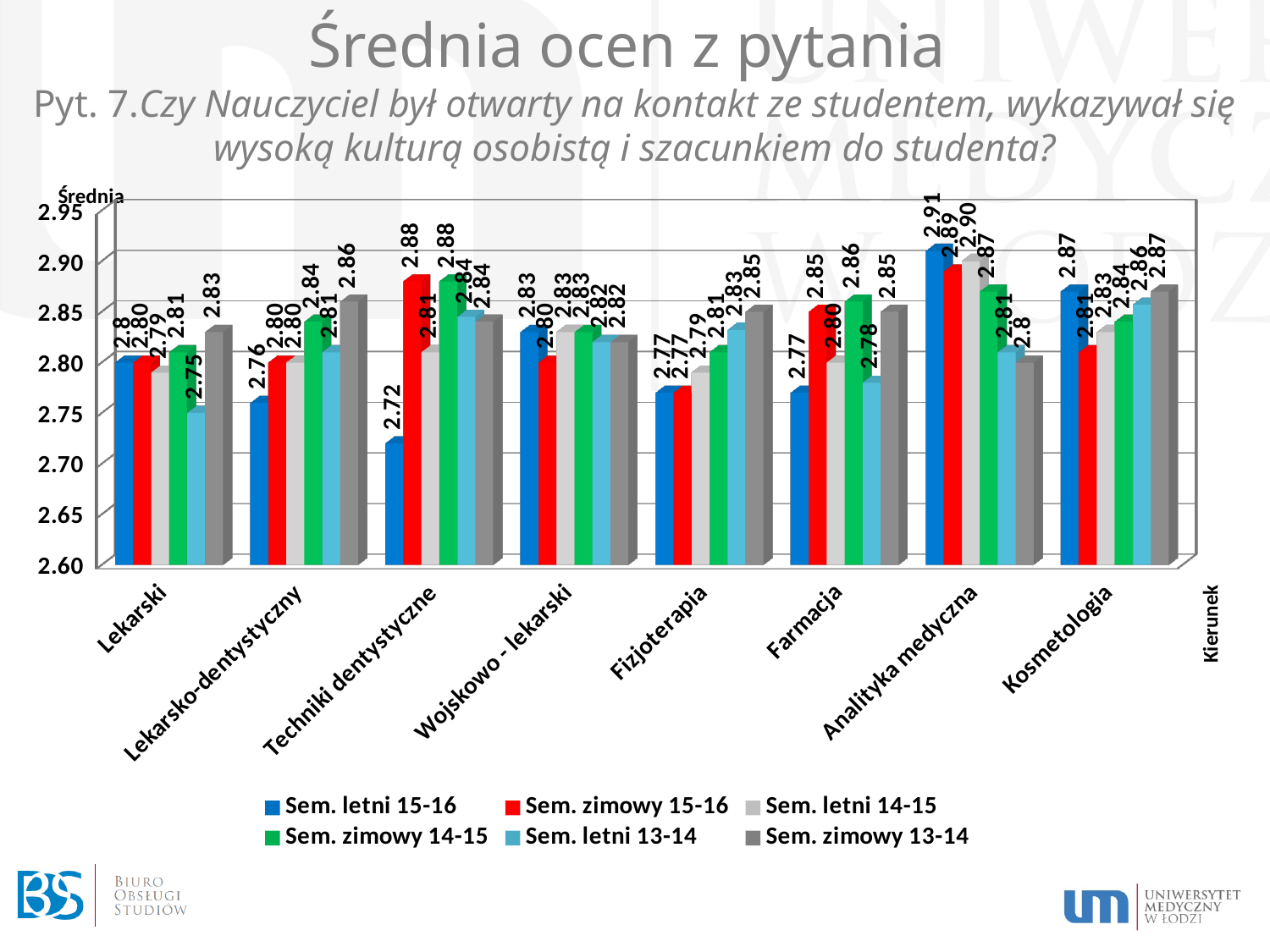
Is the Sem. letni 15-16 value for Techniki dentystyczne greater or less than 2.75? less How many categories (kierunki) are shown on the x axis? 8 Which category has the highest value in the Sem. letni 15-16 series? Analityka medyczna What is the value for Analityka medyczna in the Sem. letni 15-16 series? 2.91 What is the value for Lekarski in the Sem. letni 13-14 series? 2.75 What colour represents the Sem. zimowy 15-16 series in the legend? red Which category has the lowest value in the Sem. letni 15-16 series? Techniki dentystyczne For Techniki dentystyczne, what is the difference between the Sem. zimowy 15-16 value and the Sem. letni 15-16 value? 0.16 What is the value for Techniki dentystyczne in the Sem. letni 15-16 series? 2.72 How many series does the legend list? 6 For Farmacja, which is larger: the Sem. zimowy 15-16 value or the Sem. letni 13-14 value? Sem. zimowy 15-16 What kind of chart is shown on the slide? bar chart